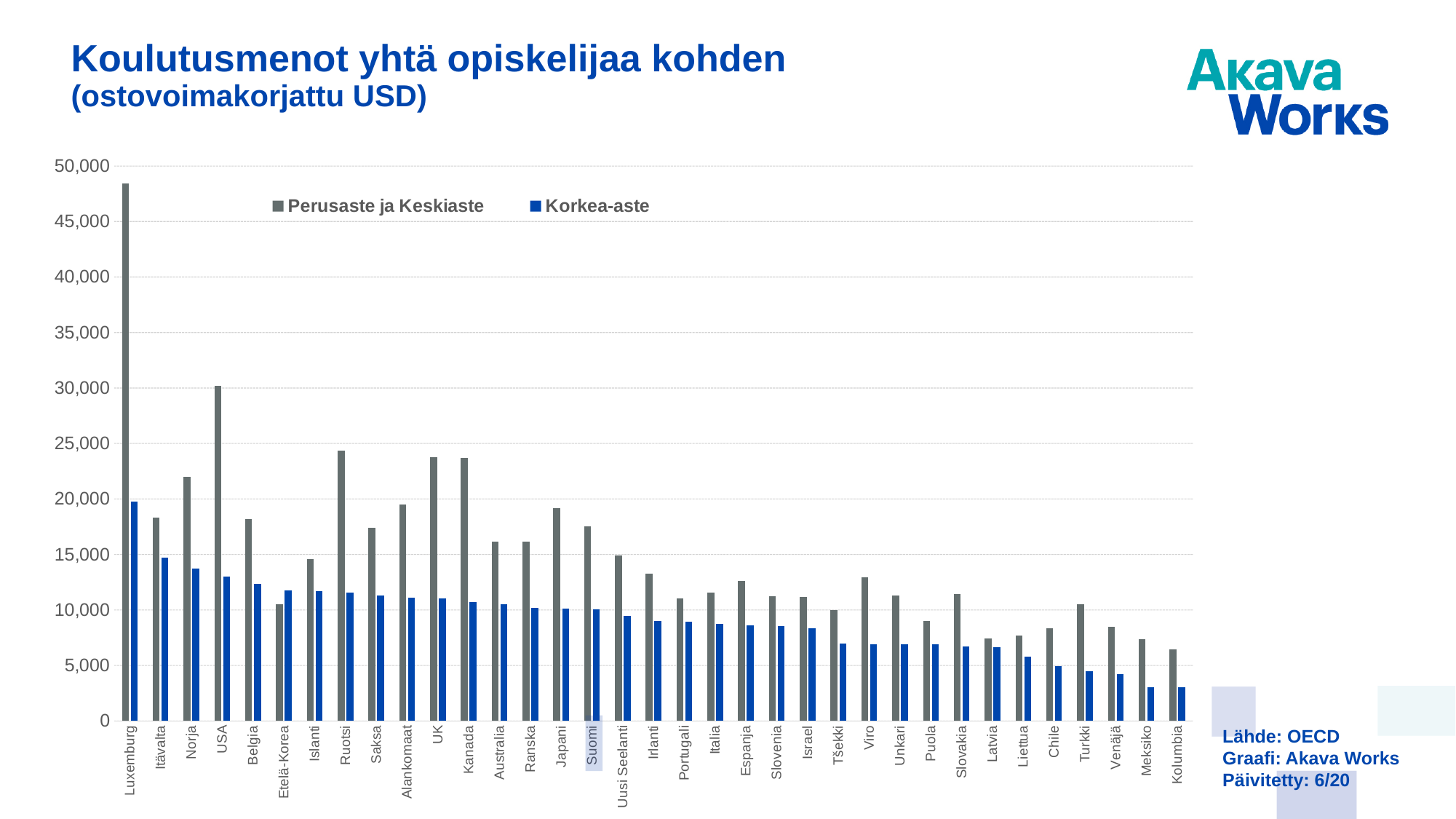
How many series does the legend list? 2 How many countries are shown on the x axis? 35 Which country has the lowest value for Perusaste ja Keskiaste? Kolumbia Do the Perusaste ja Keskiaste values generally rise or fall from left to right along the x axis? fall What kind of chart is shown on the slide? bar chart Is the Korkea-aste value for Turkki greater or less than 5,000? less Which country has the highest value for Perusaste ja Keskiaste? Luxemburg Which country has the highest value for Korkea-aste? Luxemburg Is the Perusaste ja Keskiaste value for Luxemburg greater or less than 45,000? greater Which is larger, the Perusaste ja Keskiaste value for Japani or for Suomi? Japani Is the Perusaste ja Keskiaste value for Chile greater or less than 10,000? less